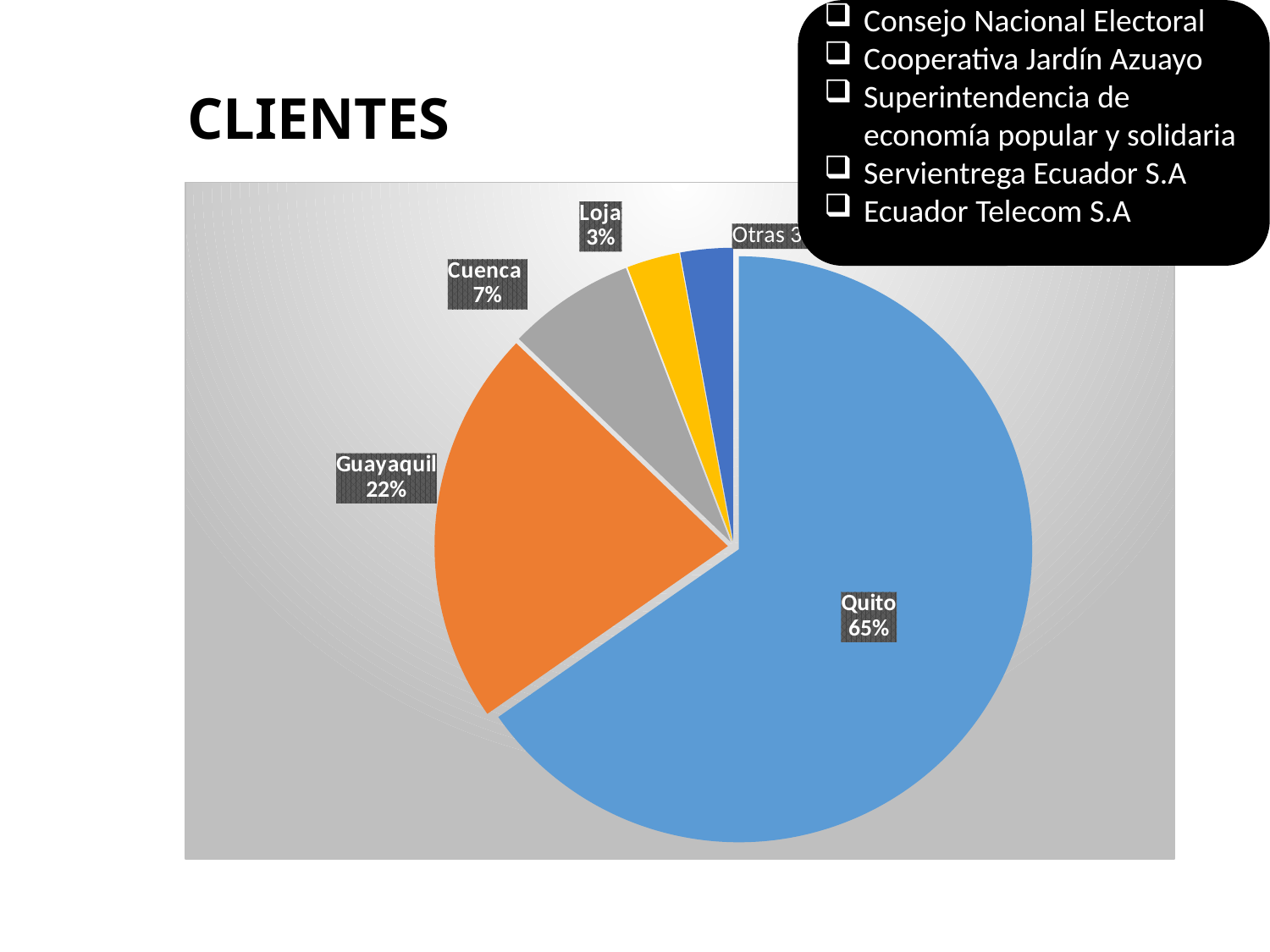
What is the difference in percentage points between Quito and Guayaquil? 43 percentage points Which is larger, the Cuenca slice or the Loja slice? Cuenca What percentage of the pie does Quito represent? 65% What is the difference in percentage points between Guayaquil and Cuenca? 15 percentage points Which slice of the pie is the largest? Quito What percentage is shown for Guayaquil? 22% Which is larger, the Guayaquil slice or the Cuenca slice? Guayaquil What percentage is shown for Loja? 3% How many slices does the pie chart have? 5 What kind of chart is shown on the slide? Pie chart What percentage is shown for Cuenca? 7% What colour is the Quito slice? Blue